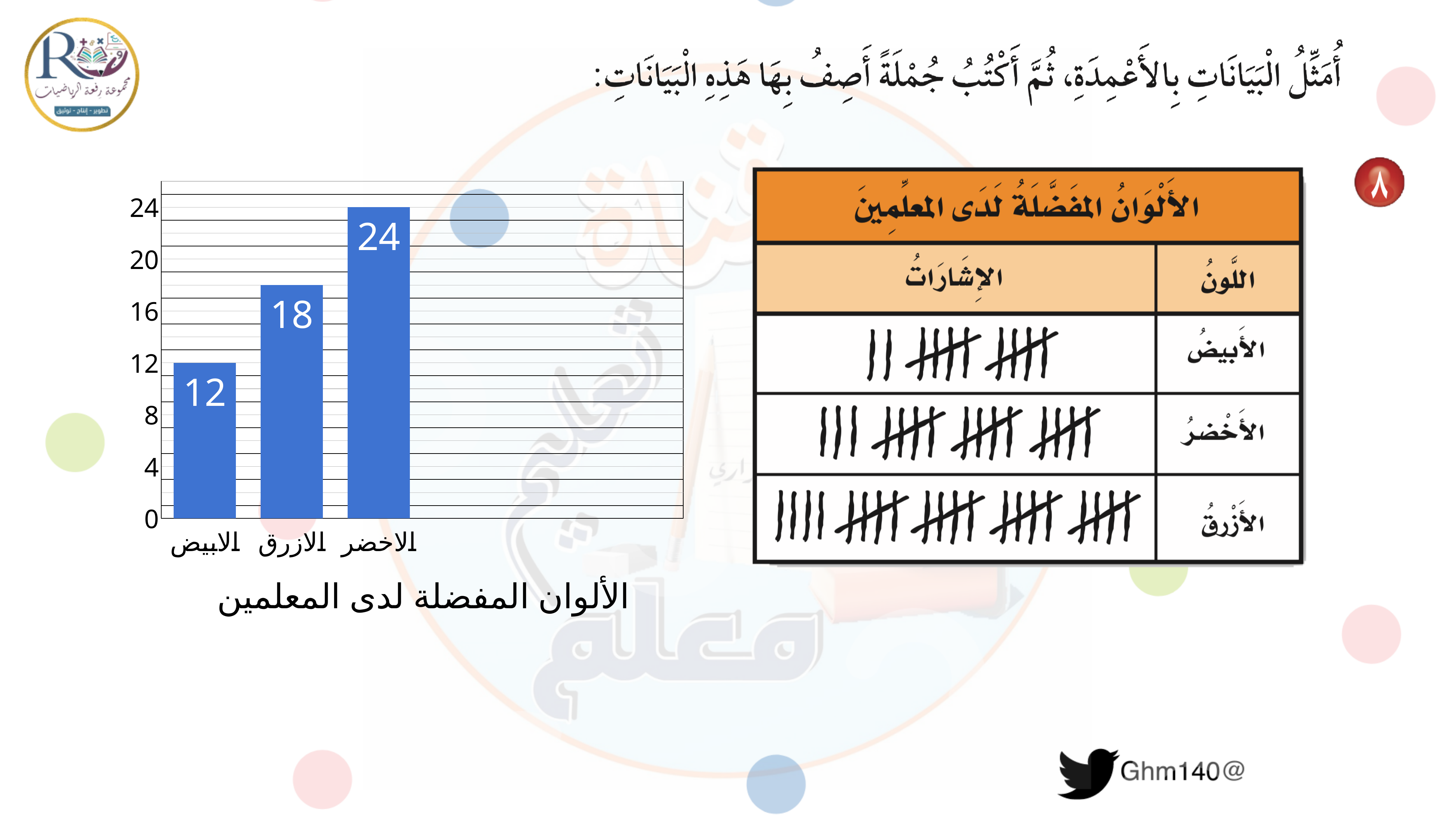
Which category has the lowest bar? الابيض What is the title written below the chart? الألوان المفضلة لدى المعلمين What is the difference between the values for الاخضر and الابيض? 12 How many categories are shown in the bar chart? 3 What is the value of the bar for الاخضر? 24 Which is larger, the value for الازرق or the value for الابيض? الازرق What is the difference between the values for الازرق and الابيض? 6 What is the value of the bar for الابيض? 12 Is the value for الازرق greater or less than 20? less What is the value of the bar for الازرق? 18 Which category has the highest bar? الاخضر What kind of chart is shown on the slide? bar chart